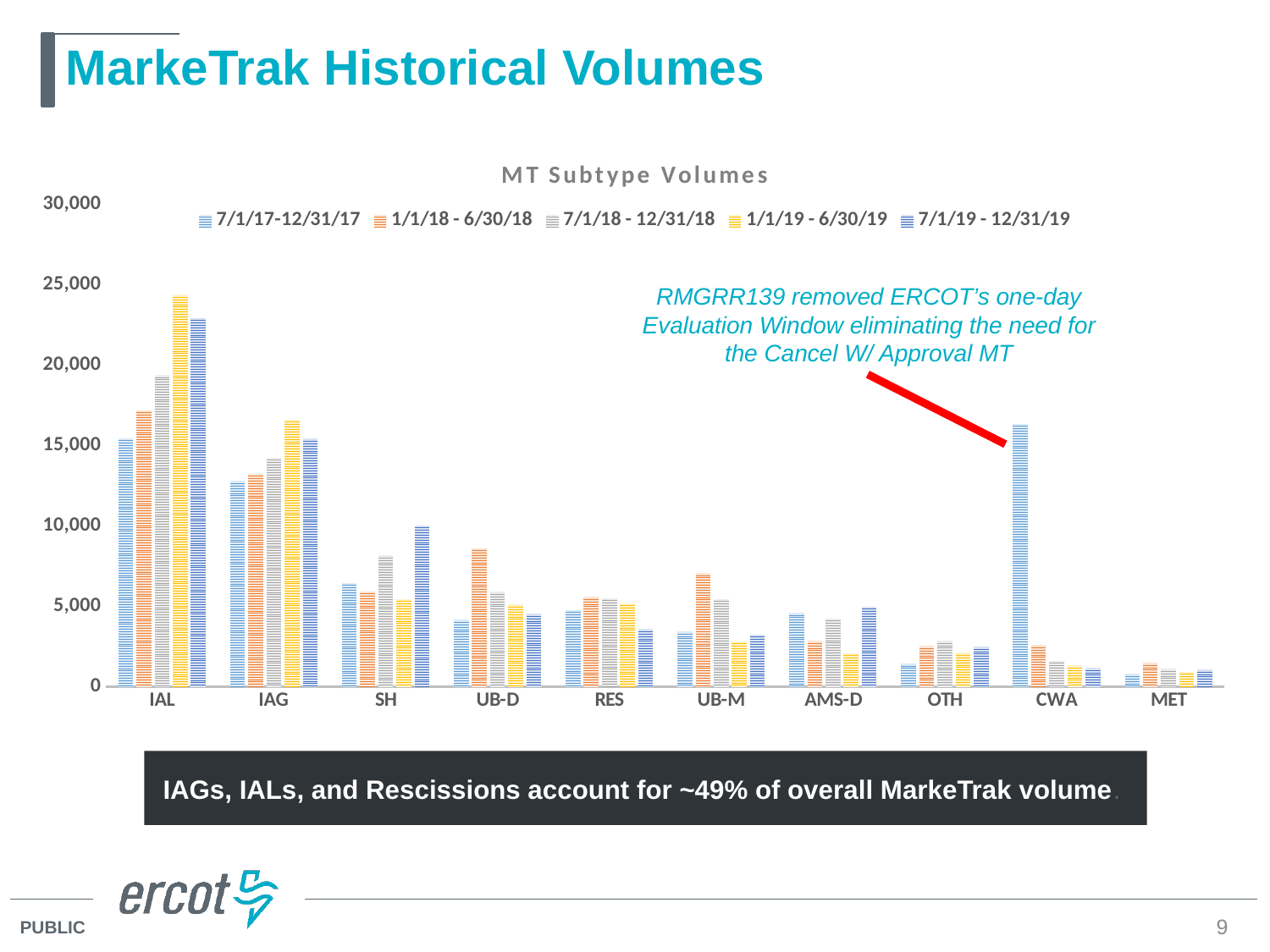
Which category contains the tallest bar in the chart? IAL Which category has the lowest bars overall in the chart? MET What kind of chart is shown on the slide? Bar chart What is the title of the chart? MT Subtype Volumes For the 7/1/17-12/31/17 period, which category has the larger value, IAL or IAG? IAL For CWA, which period has the larger value, 7/1/17-12/31/17 or 1/1/18 - 6/30/18? 7/1/17-12/31/17 Is the value for CWA in the 7/1/17-12/31/17 period greater or less than 15,000? greater Is the value for IAL in the 1/1/19 - 6/30/19 period greater or less than 20,000? greater For the CWA category, do the values rise or fall across the five periods from left to right? fall How many series does the legend of the MT Subtype Volumes chart list? 5 How many MT subtype categories are shown along the x axis? 10 Is the value for UB-M in the 1/1/18 - 6/30/18 period greater or less than 5,000? greater